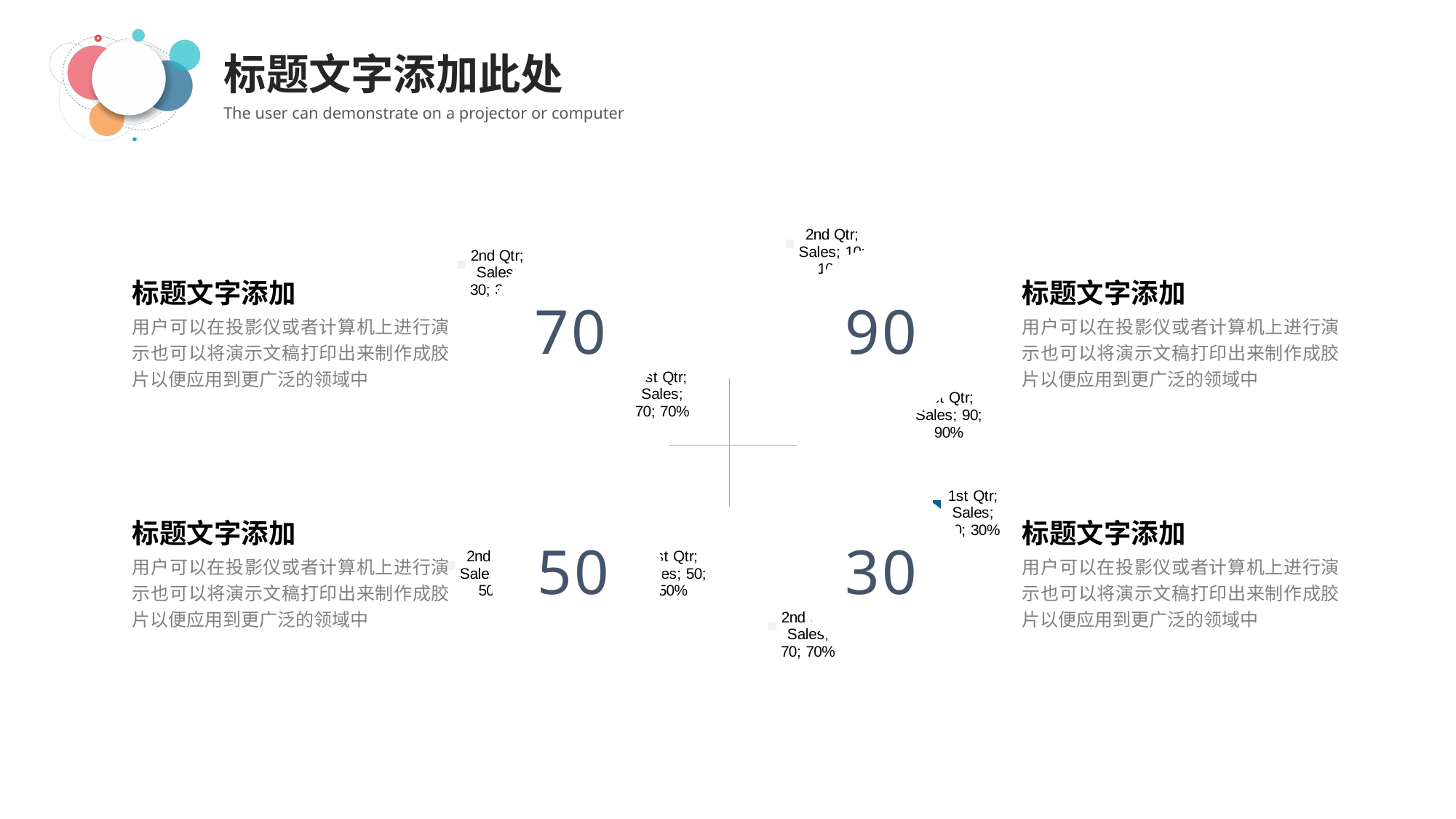
In the top-right chart, what share of the total does 1st Qtr represent? 90% In the top-right chart, which is larger, 1st Qtr or 2nd Qtr? 1st Qtr In the top-right chart, what is the value for 1st Qtr? 90 In the bottom-left chart, what share of the total does 1st Qtr represent? 50% In the top-left chart, which is larger, 1st Qtr or 2nd Qtr? 1st Qtr In the bottom-right chart, what share of the total does 2nd Qtr represent? 70% In the top-left chart, what is the value for 1st Qtr? 70 What series name appears in the data labels of the charts? Sales In the top-left chart, what is the difference between the 1st Qtr and 2nd Qtr values? 40 In the bottom-right chart, what is the value for 2nd Qtr? 70